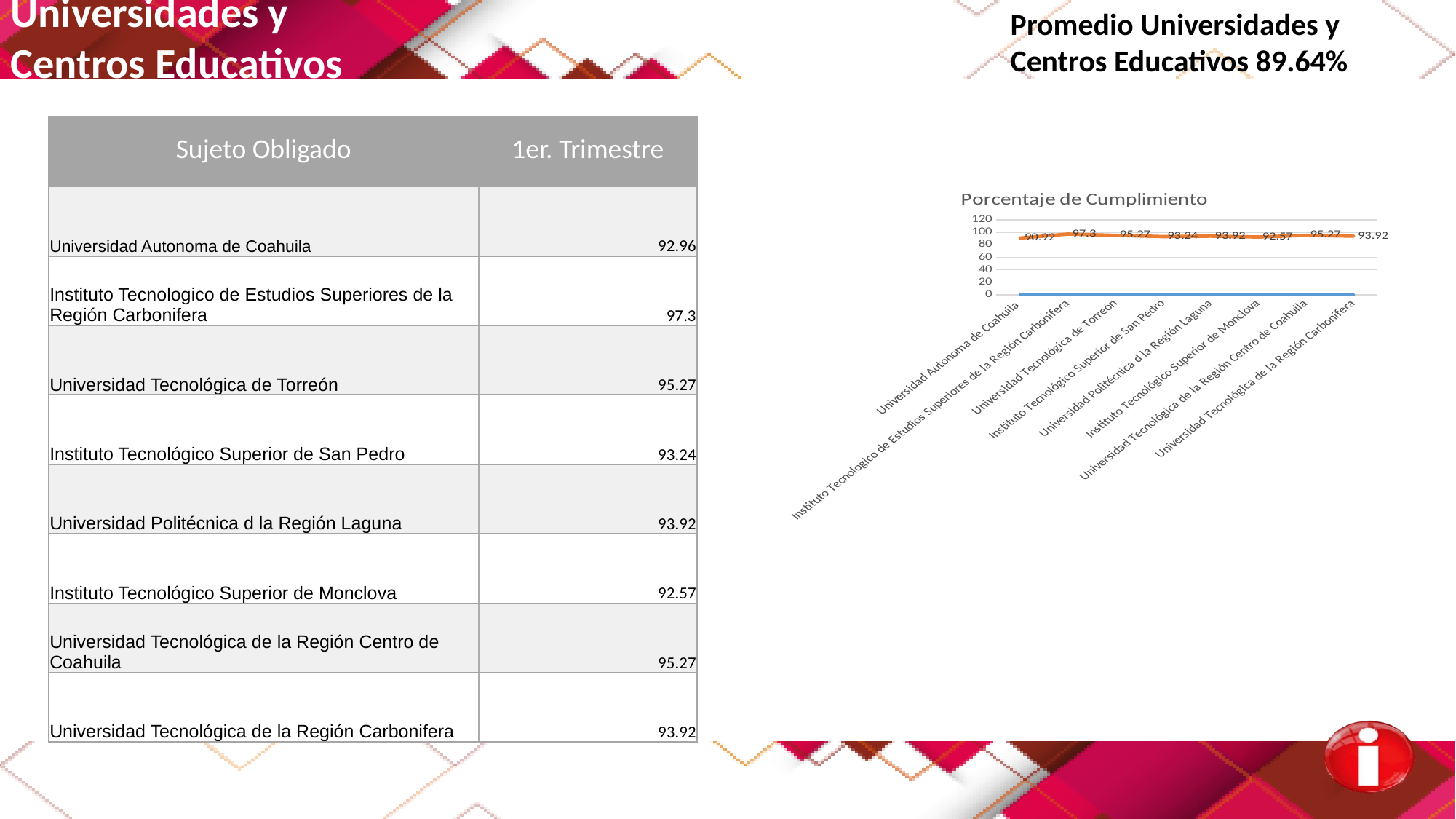
What is the value for Instituto Tecnológico Superior de San Pedro in the chart? 93.24 Which category has the highest value in the chart? Instituto Tecnologico de Estudios Superiores de la Región Carbonifera What is the highest tick value shown on the y axis of the chart? 120 Is the value for Universidad Politécnica d la Región Laguna greater or less than 80? greater What type of chart is shown on the slide? line chart Which is larger, the value for Universidad Tecnológica de Torreón or the value for Instituto Tecnológico Superior de San Pedro? Universidad Tecnológica de Torreón What is the value for Universidad Tecnológica de Torreón in the chart? 95.27 What is the value for Instituto Tecnológico Superior de Monclova in the chart? 92.57 What is the title of the chart? Porcentaje de Cumplimiento What is the value for Instituto Tecnologico de Estudios Superiores de la Región Carbonifera in the chart? 97.3 What is the difference between the values for Instituto Tecnologico de Estudios Superiores de la Región Carbonifera and Instituto Tecnológico Superior de San Pedro? 4.06 How many categories are plotted along the x axis of the chart? 8